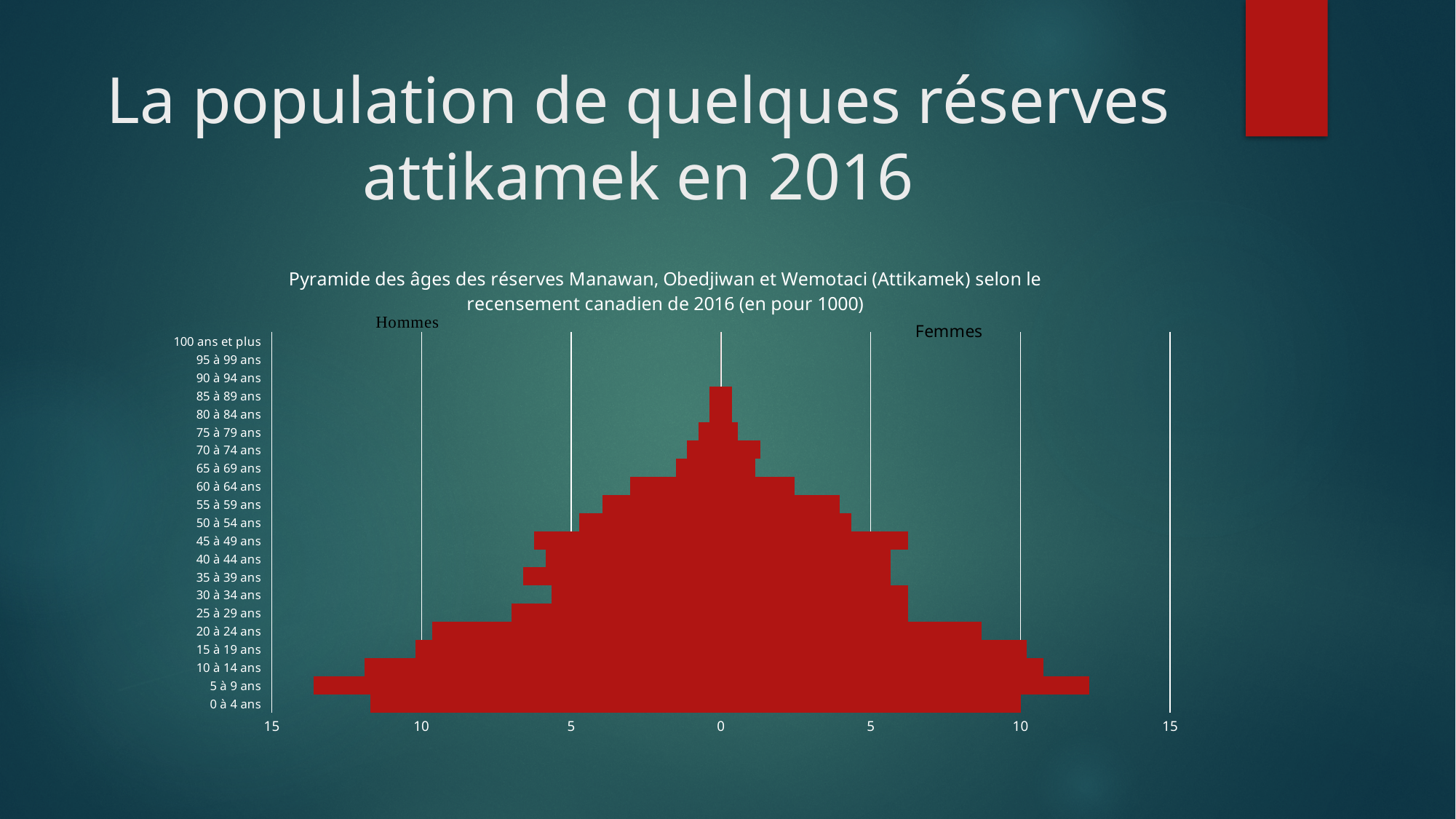
Is the Hommes value for 25 à 29 ans greater or less than 5? greater For the 5 à 9 ans age group, which side has the larger value, Hommes or Femmes? Hommes Is the Hommes value for 5 à 9 ans greater or less than 10? greater Is the Hommes value for 60 à 64 ans greater or less than 5? less Which age group has the longest bar on the Hommes side? 5 à 9 ans How many age groups are listed on the vertical axis of the pyramid? 21 Which age group has the longest bar on the Femmes side? 5 à 9 ans Which side of the pyramid shows the Hommes data, left or right? left Do the bar lengths generally increase or decrease as the age groups get older? decrease What kind of chart is shown on the slide? Bar chart (population pyramid)